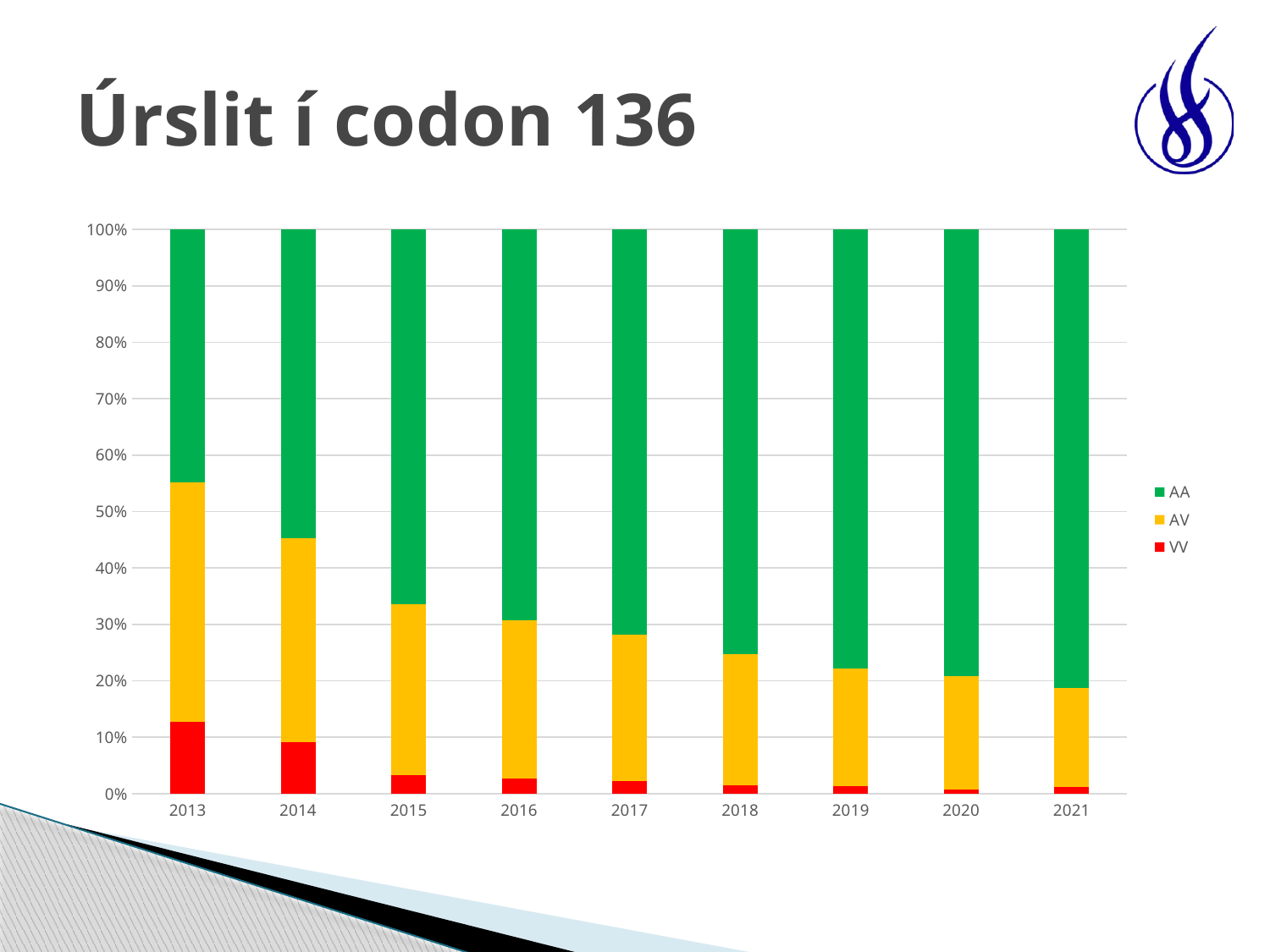
What are the three series named in the chart legend? AA, AV, VV Is the AA share in 2013 greater or less than 50%? less Which year has the larger AV (yellow) share, 2013 or 2021? 2013 Is the VV share in 2013 greater or less than 10%? greater Which year has the smallest AA (green) share? 2013 Which year has the largest VV (red) share? 2013 How many years are shown on the x axis of the chart? 9 What is the title of the slide containing the chart? Úrslit í codon 136 Does the AA (green) share rise or fall from 2013 to 2021? Rise What kind of chart is shown on the slide? Stacked bar chart How many series does the chart legend list? 3 Is the AA share in 2021 greater or less than 70%? greater